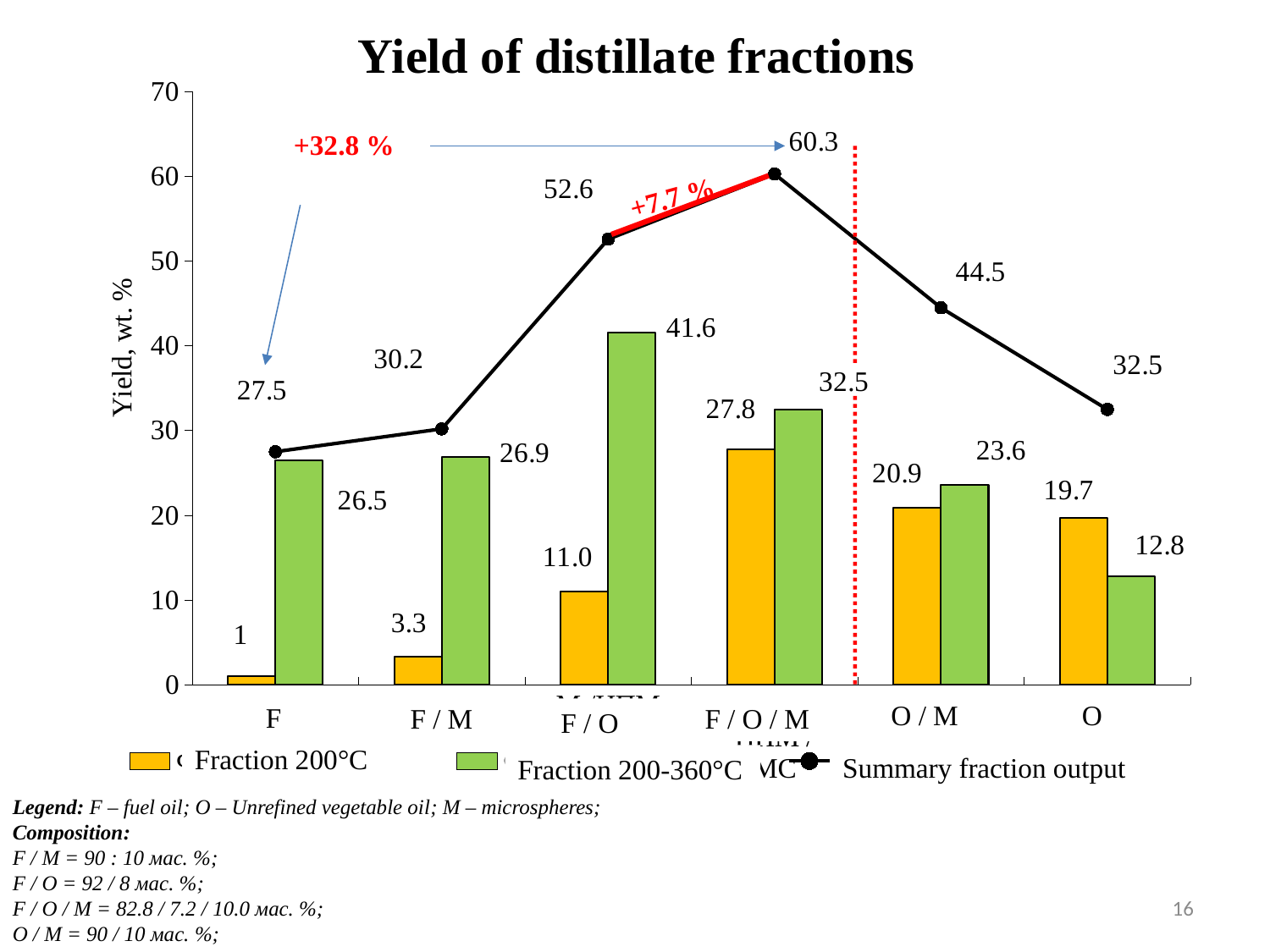
What kind of chart is used for the Fraction 200°C and Fraction 200-360°C series? bar chart What is the Fraction 200-360°C value for F / O? 41.6 What is the Summary fraction output value for F / O / M? 60.3 Which category has the highest Summary fraction output? F / O / M How many categories are shown on the x axis? 6 Which is larger for O: the Fraction 200°C value or the Fraction 200-360°C value? Fraction 200°C Is the Fraction 200-360°C value for F / O greater or less than 40? greater What is the difference between the Summary fraction output for F / O / M and for F / O? 7.7 What is the Fraction 200°C value for O / M? 20.9 Which category has the lowest Fraction 200°C value? F How many series does the legend list? 3 What is the title of the chart? Yield of distillate fractions